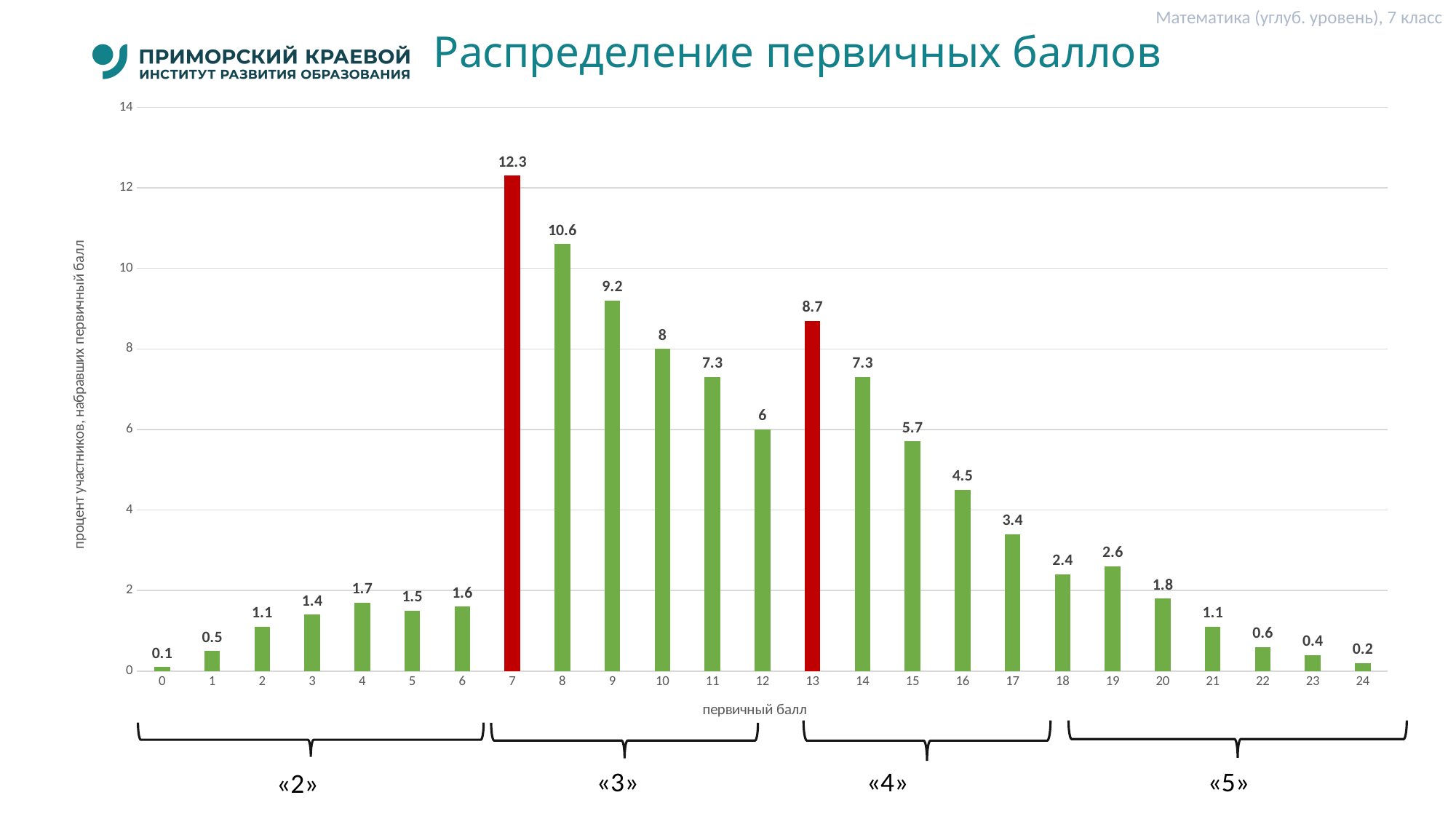
How many primary score categories are shown on the x axis? 25 Is the value for primary score 10 greater or less than 6? greater What is the value shown for primary score 19? 2.6 Do the values rise or fall along the x axis from primary score 13 to 24? fall What is the value shown for primary score 13? 8.7 What percentage of participants scored a primary score of 7? 12.3 Which has a larger value: primary score 9 or primary score 14? 9 Which primary score has the lowest percentage of participants? 0 What is the difference between the values for primary scores 7 and 8? 1.7 Which two bars are coloured red instead of green? 7 and 13 What type of chart is shown on the slide? bar chart Which primary score has the highest percentage of participants? 7